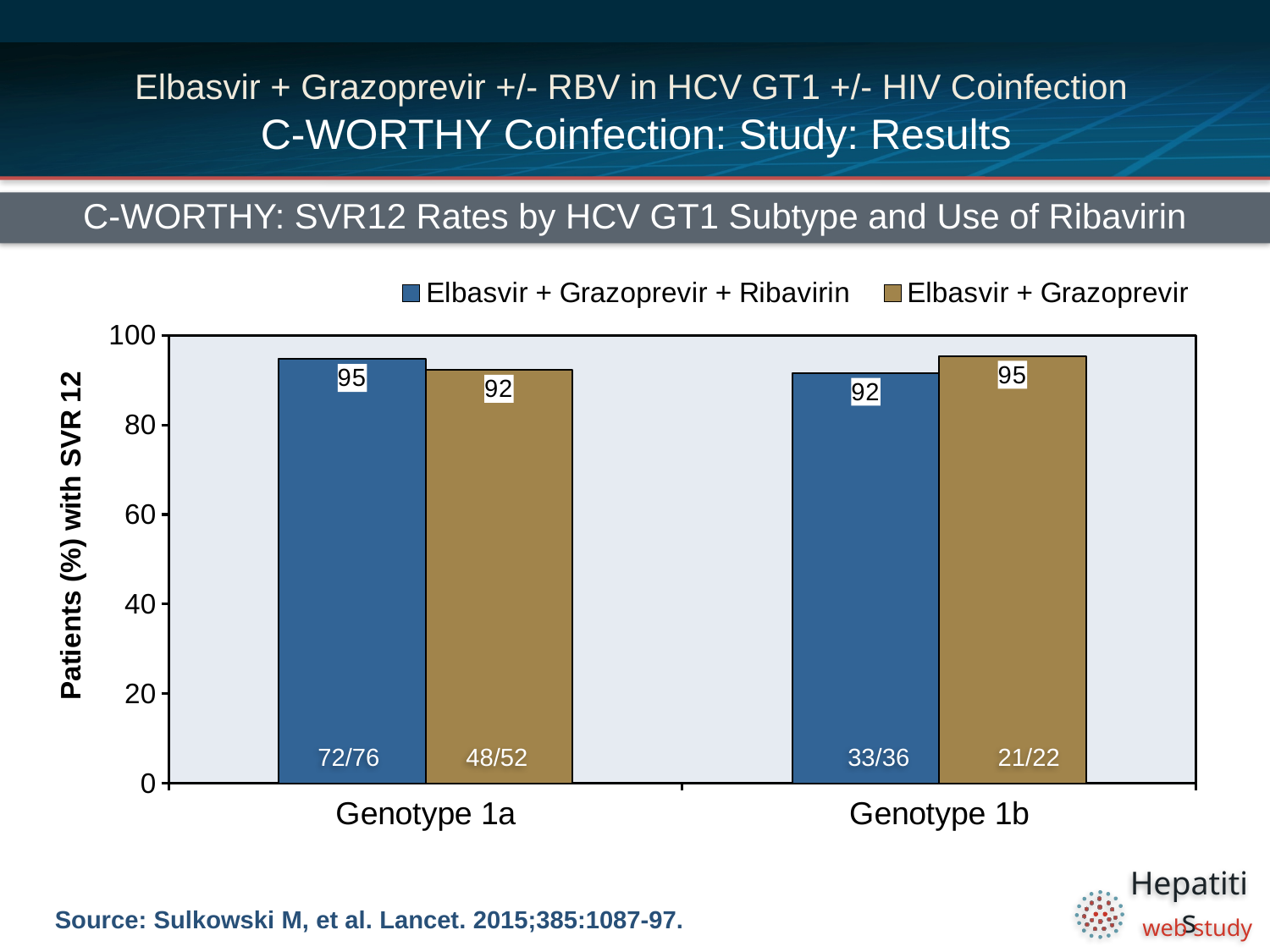
What patient fraction is shown inside the Elbasvir + Grazoprevir + Ribavirin bar for Genotype 1a? 72/76 What is the SVR12 rate for Elbasvir + Grazoprevir + Ribavirin in Genotype 1a? 95 What is the label of the y axis? Patients (%) with SVR 12 What kind of chart is shown on the slide? Bar chart What is the SVR12 rate for Elbasvir + Grazoprevir (without ribavirin) in Genotype 1b? 95 How many genotype categories are shown on the x axis? 2 In Genotype 1b, which regimen has the higher SVR12 rate? Elbasvir + Grazoprevir What is the difference between the SVR12 rates of the two regimens in Genotype 1a? 3 How many series does the legend list? 2 What is the SVR12 rate for Elbasvir + Grazoprevir + Ribavirin in Genotype 1b? 92 What patient fraction is shown inside the Elbasvir + Grazoprevir bar for Genotype 1b? 21/22 What is the SVR12 rate for Elbasvir + Grazoprevir (without ribavirin) in Genotype 1a? 92